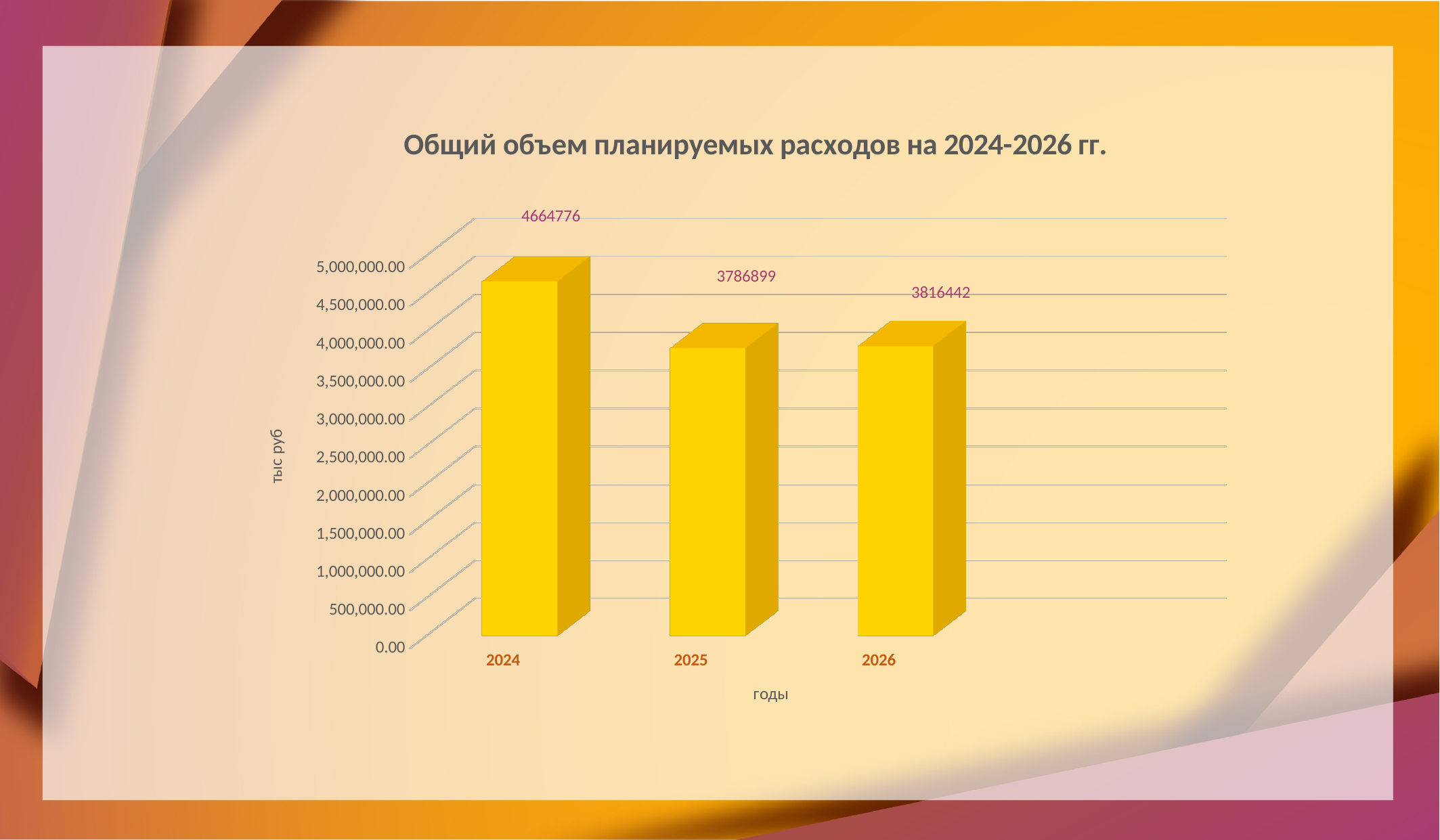
Which is larger, the value for 2025 or the value for 2026? 2026 What kind of chart is shown on the slide? bar chart What is the value for 2025? 3786899 Which year has the lowest planned expenditure? 2025 What is the difference between the values for 2026 and 2025? 29543 What is the difference between the values for 2024 and 2025? 877877 What is the value for 2024? 4664776 What is the value for 2026? 3816442 Which year has the highest planned expenditure? 2024 How many years are shown on the x axis? 3 What is the title of the chart? Общий объем планируемых расходов на 2024-2026 гг. Is the value for 2025 greater or less than 4,000,000.00? less